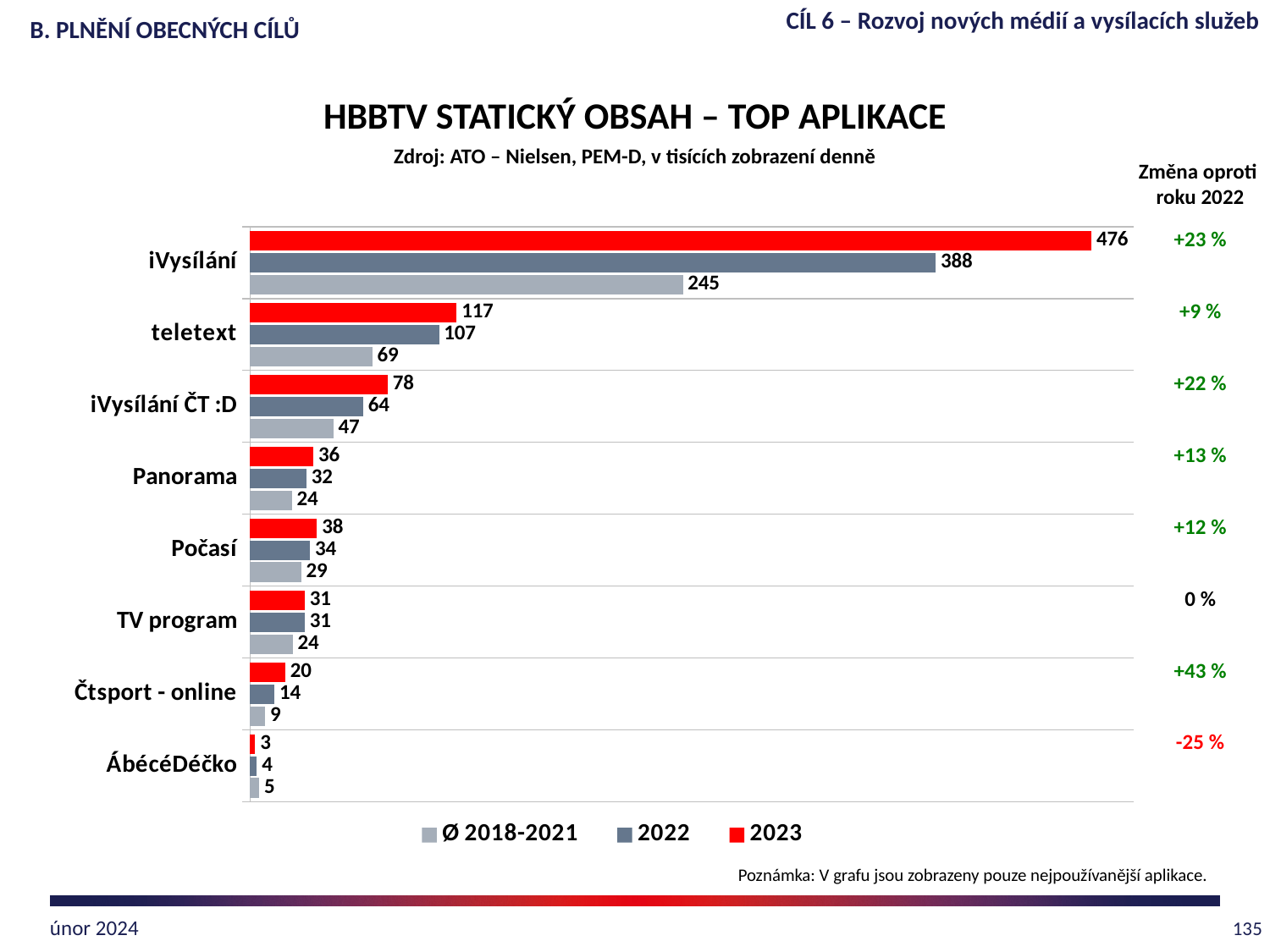
Which application has the lowest 2023 value? ÁbécéDéčko What kind of chart is shown? bar chart What is the change versus 2022 shown for Čtsport - online? +43 % How many series does the legend list? 3 Which colour represents the 2023 series in the legend? red What is the 2023 value for iVysílání? 476 What is the difference between the 2023 and 2022 values for iVysílání? 88 Which application has the highest 2023 value? iVysílání What is the Ø 2018-2021 value for Panorama? 24 How many applications are shown in the chart? 8 Which is larger for Počasí: the 2023 value or the Ø 2018-2021 value? 2023 What is the 2022 value for teletext? 107